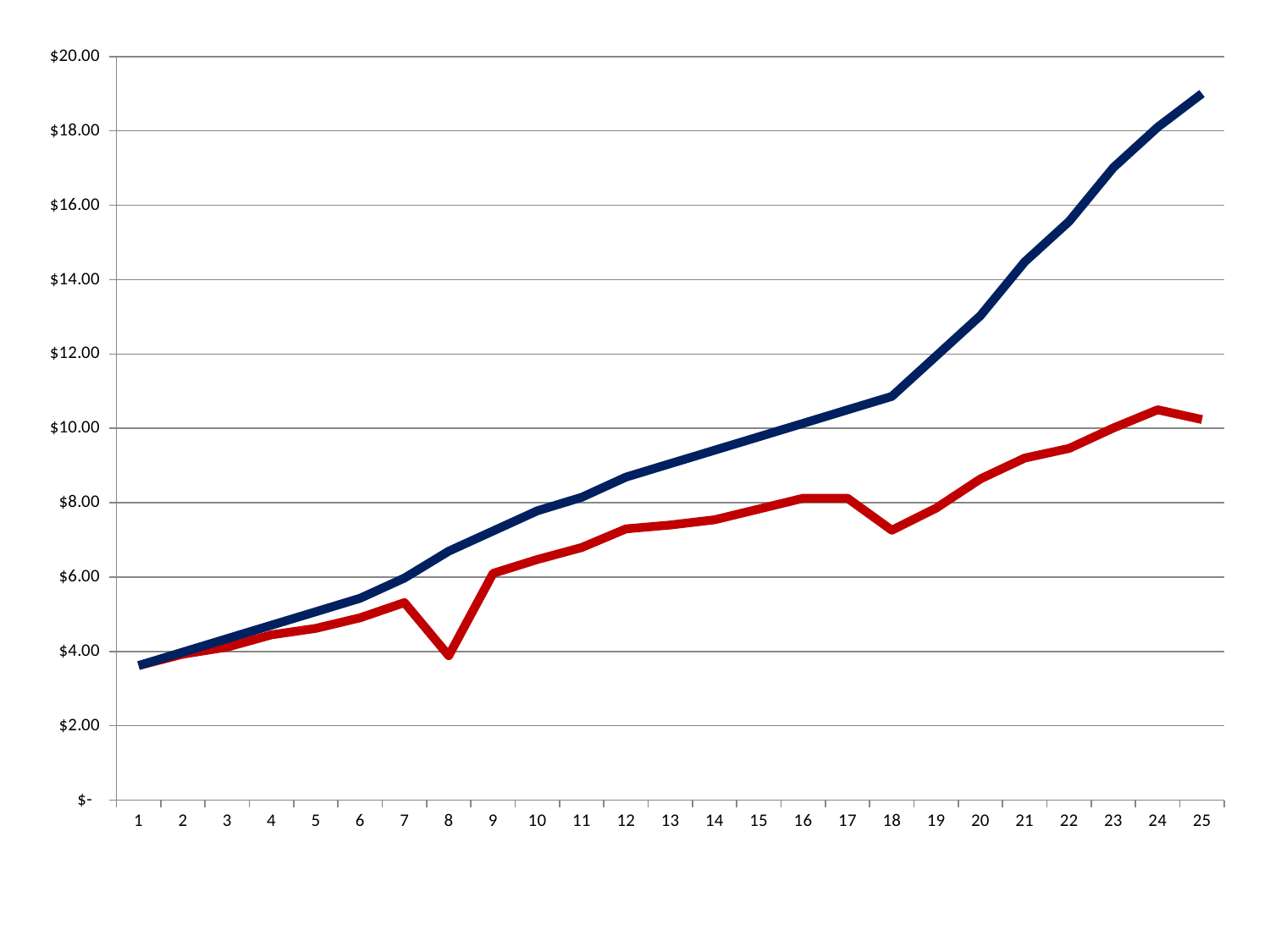
What kind of chart is shown on the slide? line chart Is the value of the dark blue line at point 25 greater or less than $18.00? greater Is the value of the red line at point 8 greater or less than $6.00? less At which x-axis point does the dark blue line reach its highest value? 25 How many points are there along the x axis of the chart? 25 Is the value of the dark blue line at point 16 greater or less than $8.00? greater What colours are the two lines on the chart? dark blue and red At point 25, which line has the higher value, the dark blue line or the red line? the dark blue line Does the dark blue line generally rise or fall from point 1 to point 25? rise How many lines are plotted on the chart? 2